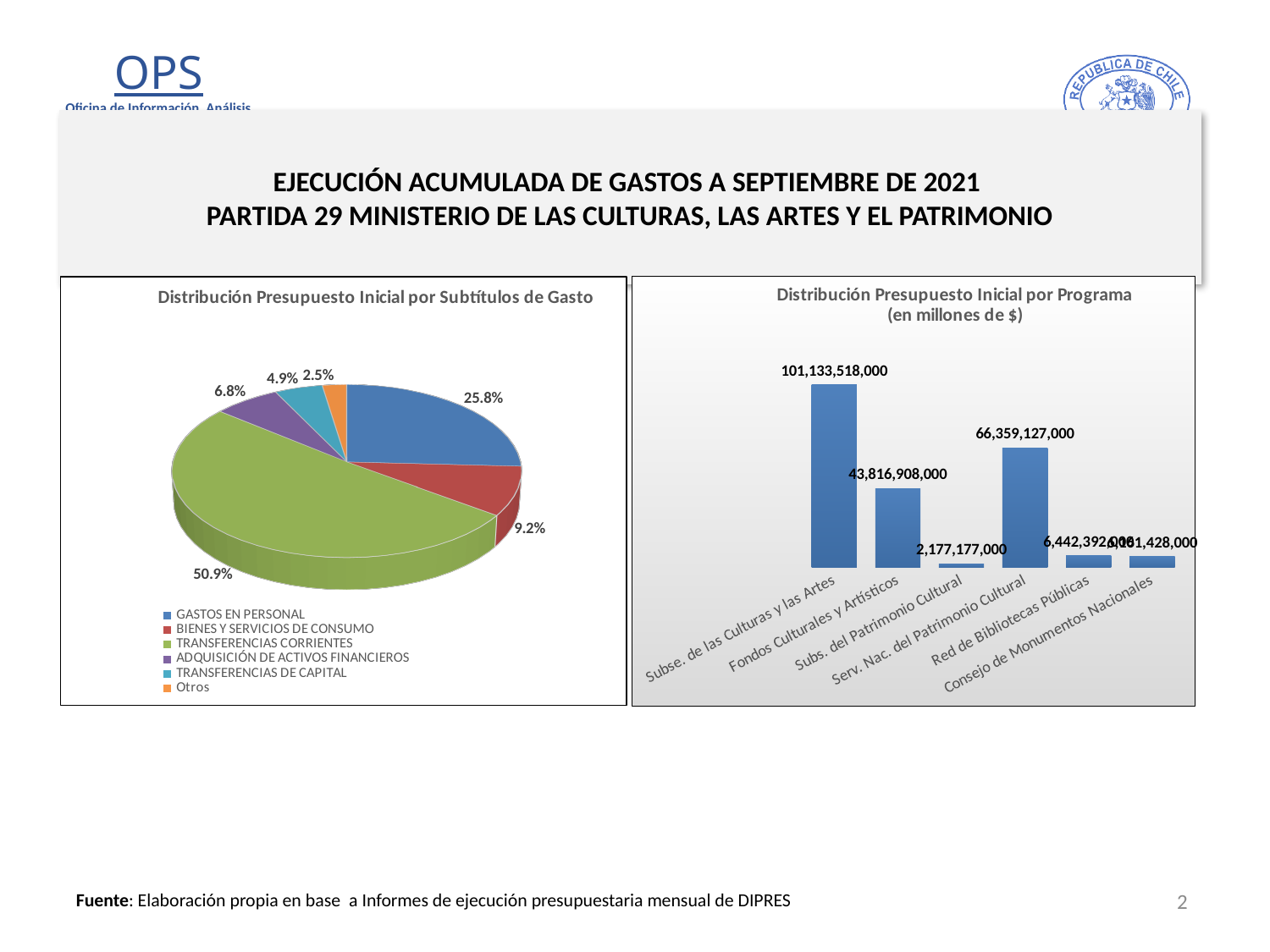
In the chart 'Distribución Presupuesto Inicial por Subtítulos de Gasto', which category has the largest share? TRANSFERENCIAS CORRIENTES What kind of chart is 'Distribución Presupuesto Inicial por Subtítulos de Gasto'? Pie chart In the chart 'Distribución Presupuesto Inicial por Programa', which is larger: Fondos Culturales y Artísticos or Serv. Nac. del Patrimonio Cultural? Serv. Nac. del Patrimonio Cultural In the chart 'Distribución Presupuesto Inicial por Programa', what is the value for Serv. Nac. del Patrimonio Cultural? 66,359,127,000 In the chart 'Distribución Presupuesto Inicial por Programa', which program has the highest value? Subse. de las Culturas y las Artes What kind of chart is 'Distribución Presupuesto Inicial por Programa'? Bar chart In the chart 'Distribución Presupuesto Inicial por Subtítulos de Gasto', what is the difference between the shares of GASTOS EN PERSONAL and BIENES Y SERVICIOS DE CONSUMO? 16.6% In the chart 'Distribución Presupuesto Inicial por Subtítulos de Gasto', how many categories does the legend list? 6 In the chart 'Distribución Presupuesto Inicial por Subtítulos de Gasto', what share does GASTOS EN PERSONAL have? 25.8% In the chart 'Distribución Presupuesto Inicial por Subtítulos de Gasto', what share does TRANSFERENCIAS CORRIENTES have? 50.9% In the chart 'Distribución Presupuesto Inicial por Subtítulos de Gasto', which category has the smallest share? Otros In the chart 'Distribución Presupuesto Inicial por Programa', what is the value for Subse. de las Culturas y las Artes? 101,133,518,000